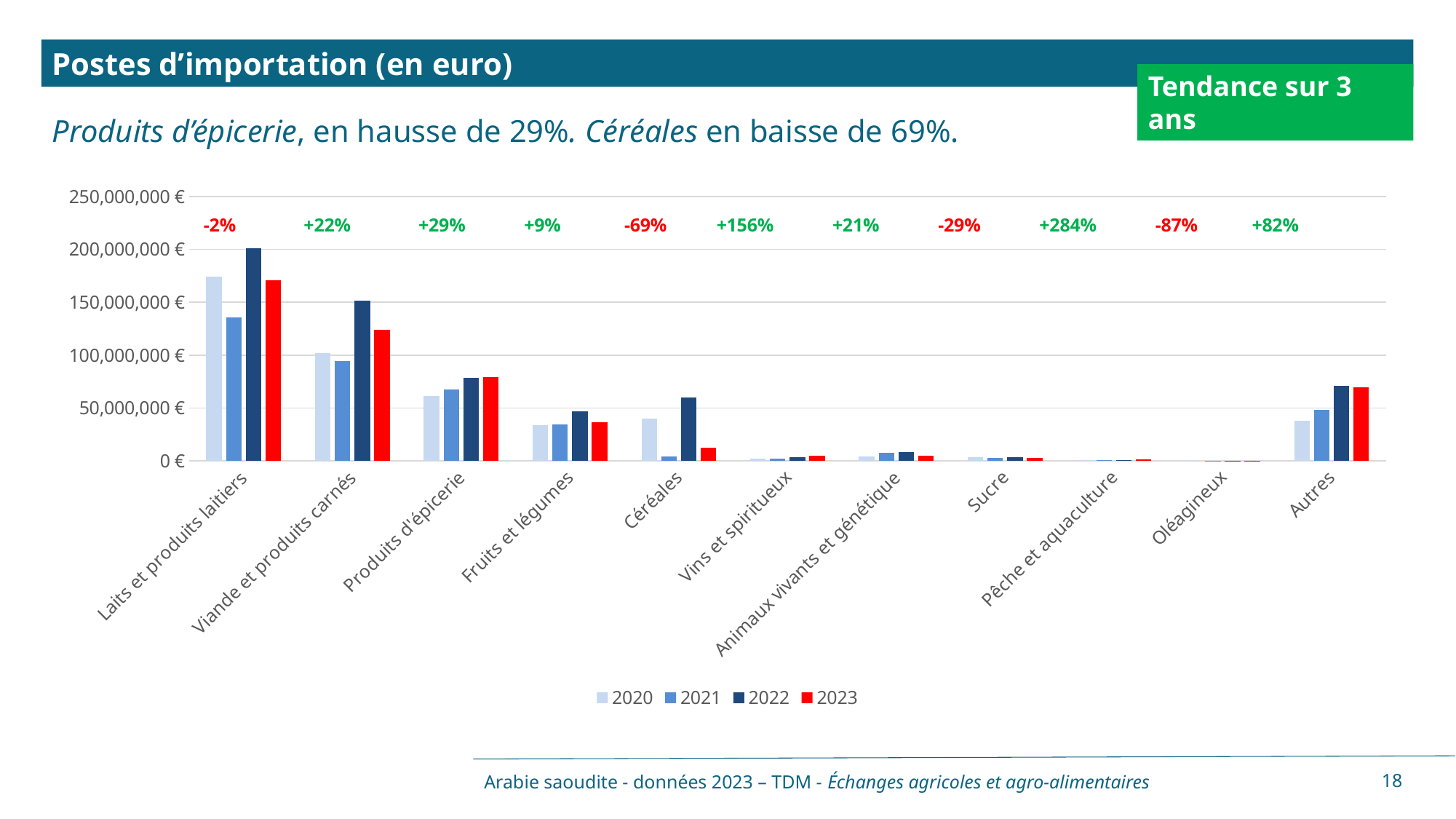
What 3-year trend percentage is shown above the Céréales group? -69% How many import categories are shown along the x axis of the chart? 11 How many series does the chart legend list? 4 Which category has the tallest 2022 bar? Laits et produits laitiers What 3-year trend percentage is shown above the Oléagineux group? -87% Which category has the lowest 3-year trend percentage label? Oléagineux What colour represents the 2023 series in the chart? red Which category has the highest 3-year trend percentage label? Pêche et aquaculture What 3-year trend percentage is shown above the Sucre group? -29% For Céréales, which is larger: the 2022 value or the 2023 value? 2022 Is the 2022 value for Laits et produits laitiers greater or less than 150,000,000 €? greater What kind of chart is shown on the slide? bar chart